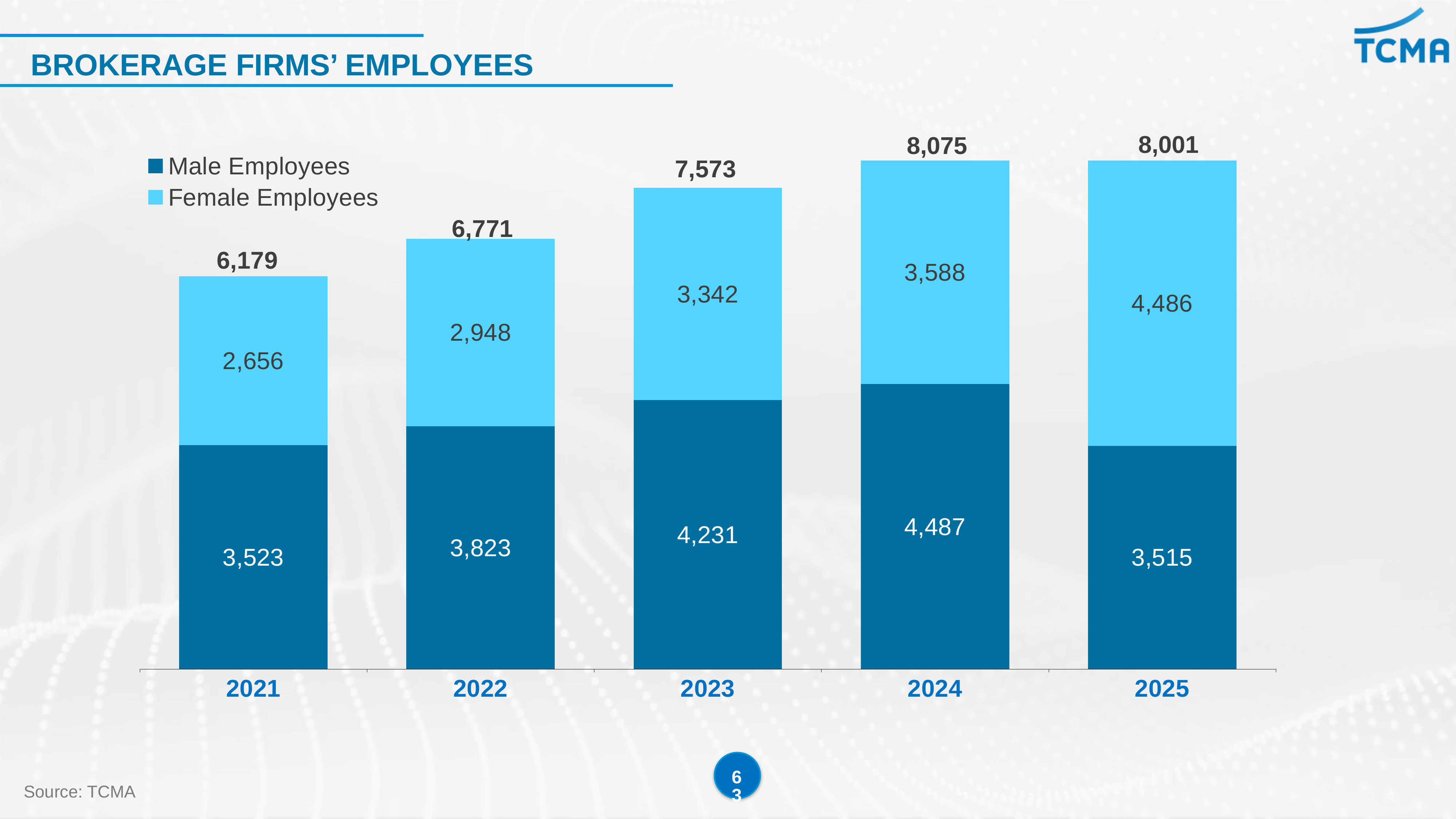
How many female employees did brokerage firms have in 2025? 4,486 Which year has the lowest number of female employees? 2021 How many male employees did brokerage firms have in 2023? 4,231 What kind of chart is shown on the slide? Stacked bar chart How many years are shown on the x axis? 5 How many series does the legend list? 2 What is the title of the chart? BROKERAGE FIRMS' EMPLOYEES In 2025, are there more male or female employees? Female employees How does the number of female employees change from 2021 to 2025? It rises What is the total number of brokerage firms' employees in 2022? 6,771 Which year has the highest total number of employees? 2024 What is the difference between male and female employees in 2021? 867